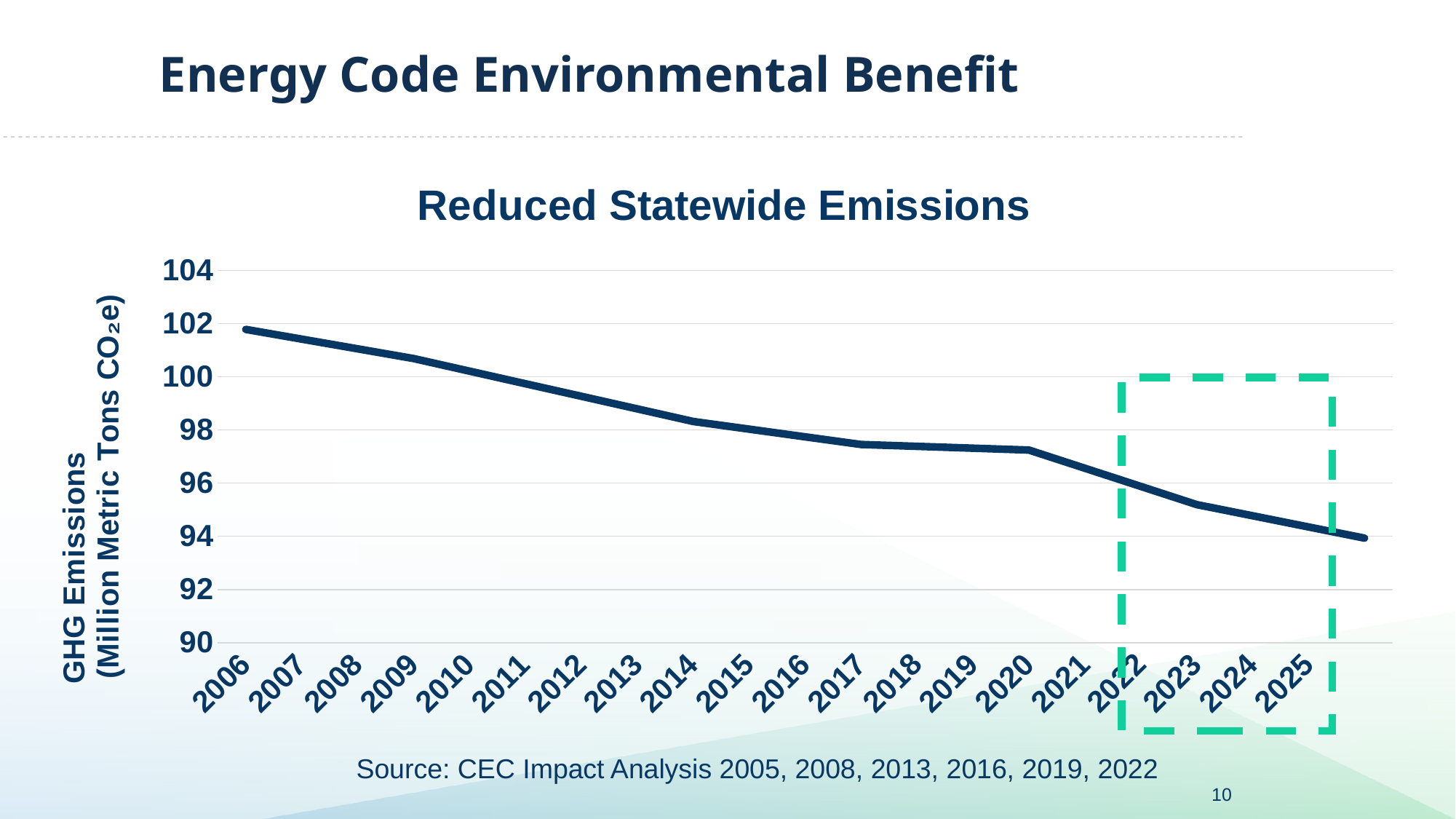
What is the title of the chart? Reduced Statewide Emissions Is the value for 2020 greater or less than 96? greater Which year has the highest emissions value? 2006 Is the value for 2006 greater or less than 100? greater What is the label on the vertical axis of the chart? GHG Emissions (Million Metric Tons CO₂e) How many years are shown along the x axis of the chart? 20 Which year has the lowest emissions value? 2025 Do the emissions values rise or fall from 2006 to 2025? fall Is the value for 2014 greater or less than 100? less Which year has the larger emissions value, 2008 or 2018? 2008 What kind of chart is shown on the slide? line chart